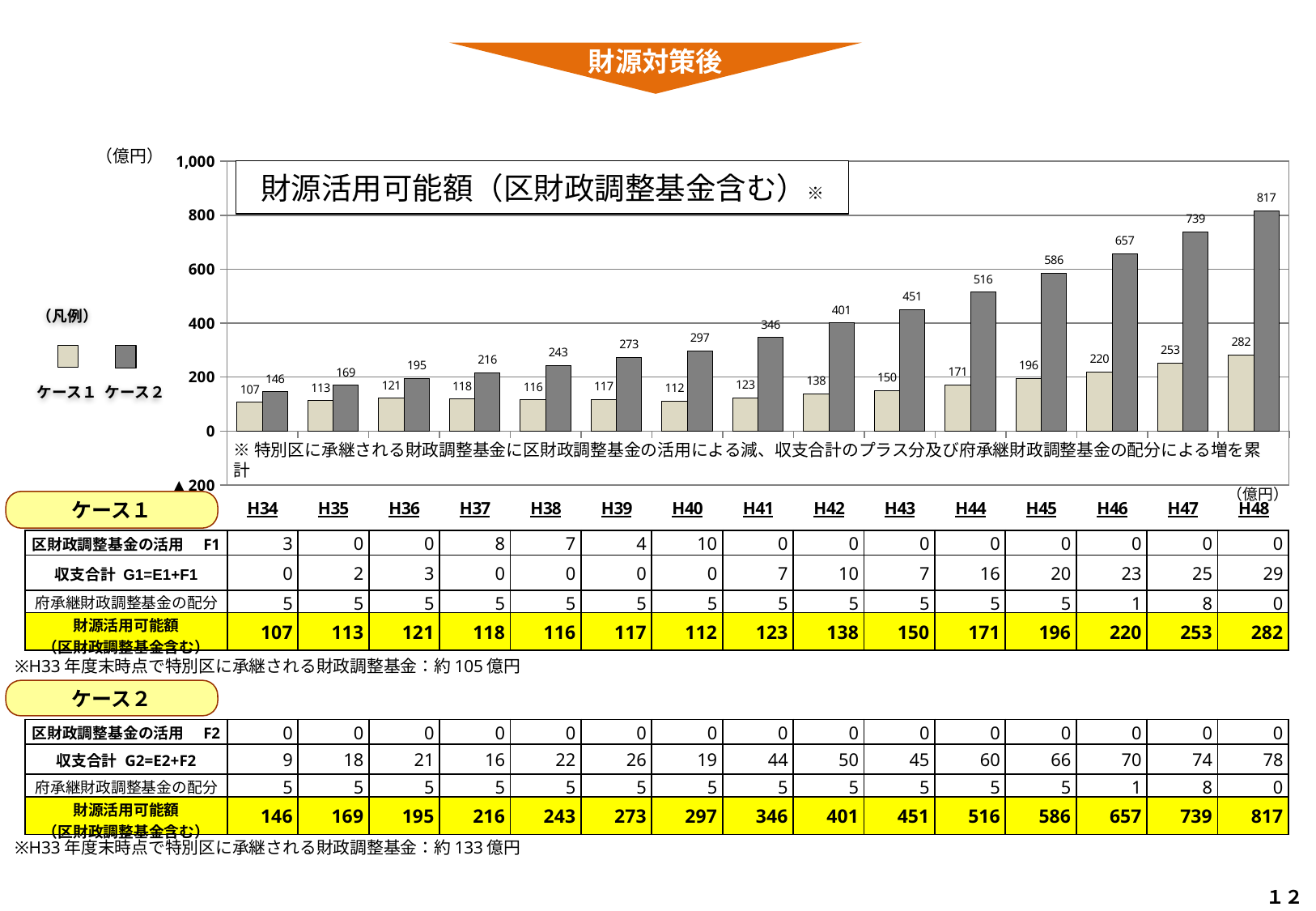
What is the value for ケース2 in H42? 401 What is the value for ケース1 in H40? 112 What is the value for ケース1 in H45? 196 In H38, which is larger, ケース1 or ケース2? ケース2 What kind of chart is shown on the slide? bar chart Is the value for ケース2 in H44 greater or less than 400? greater In which year is the ケース2 value highest? H48 In which year is the ケース1 value lowest? H34 How many series does the legend list? 2 How many years are shown on the x axis of the chart? 15 What is the difference between ケース2 and ケース1 in H48? 535 Do the ケース2 values rise or fall from H34 to H48? rise